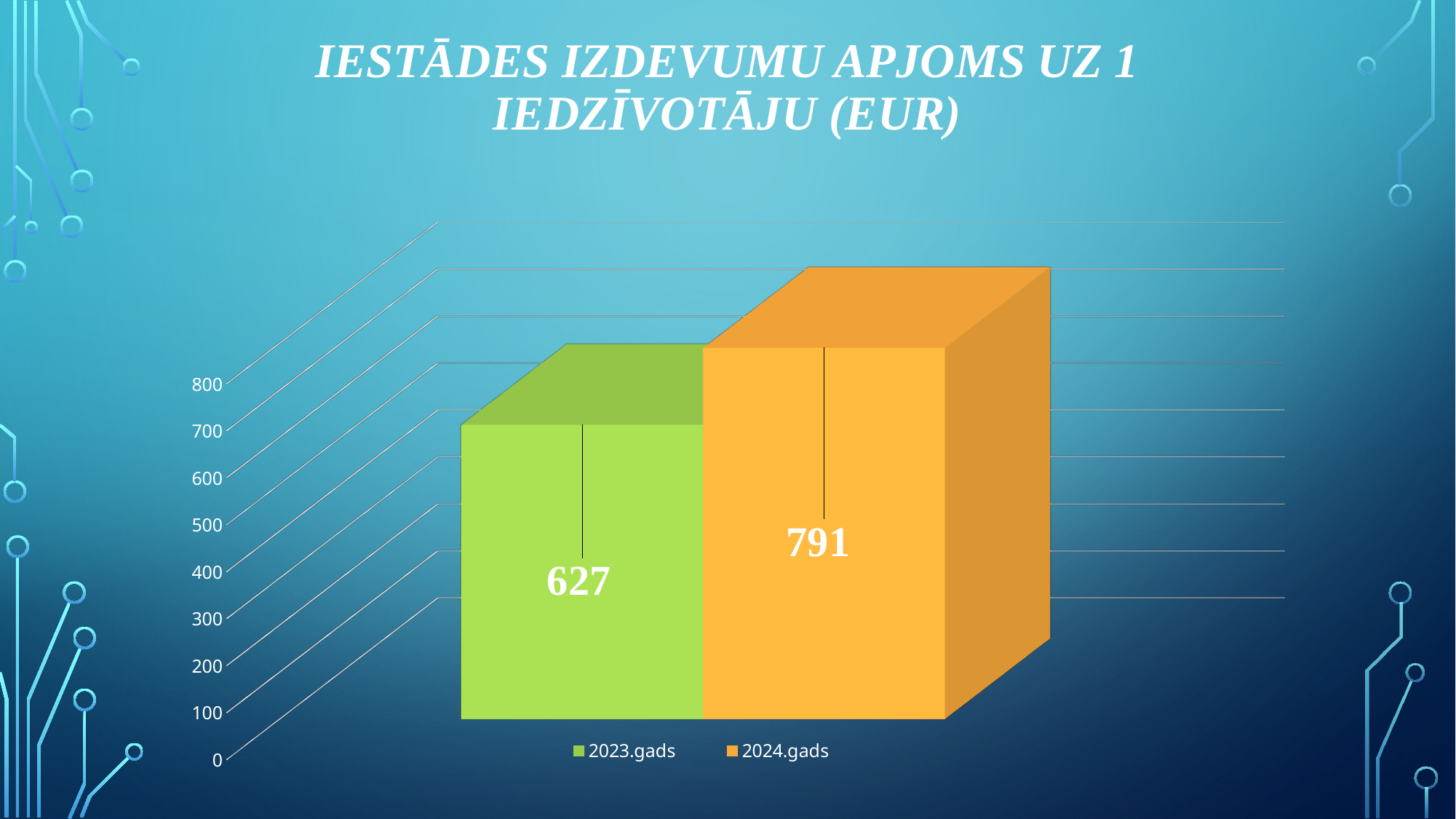
What is the difference between the 2024.gads value and the 2023.gads value? 164 How many series does the legend list? 2 Which series has the highest value? 2024.gads Is the value for 2024.gads greater or less than 800? less What is the title of the chart? Iestādes izdevumu apjoms uz 1 iedzīvotāju (EUR) What is the value for 2023.gads? 627 What colour is the bar for 2024.gads? orange Is the value for 2023.gads greater or less than 600? greater What kind of chart is shown on the slide? bar chart What is the value for 2024.gads? 791 Which series has the higher value, 2023.gads or 2024.gads? 2024.gads Which series has the lowest value? 2023.gads